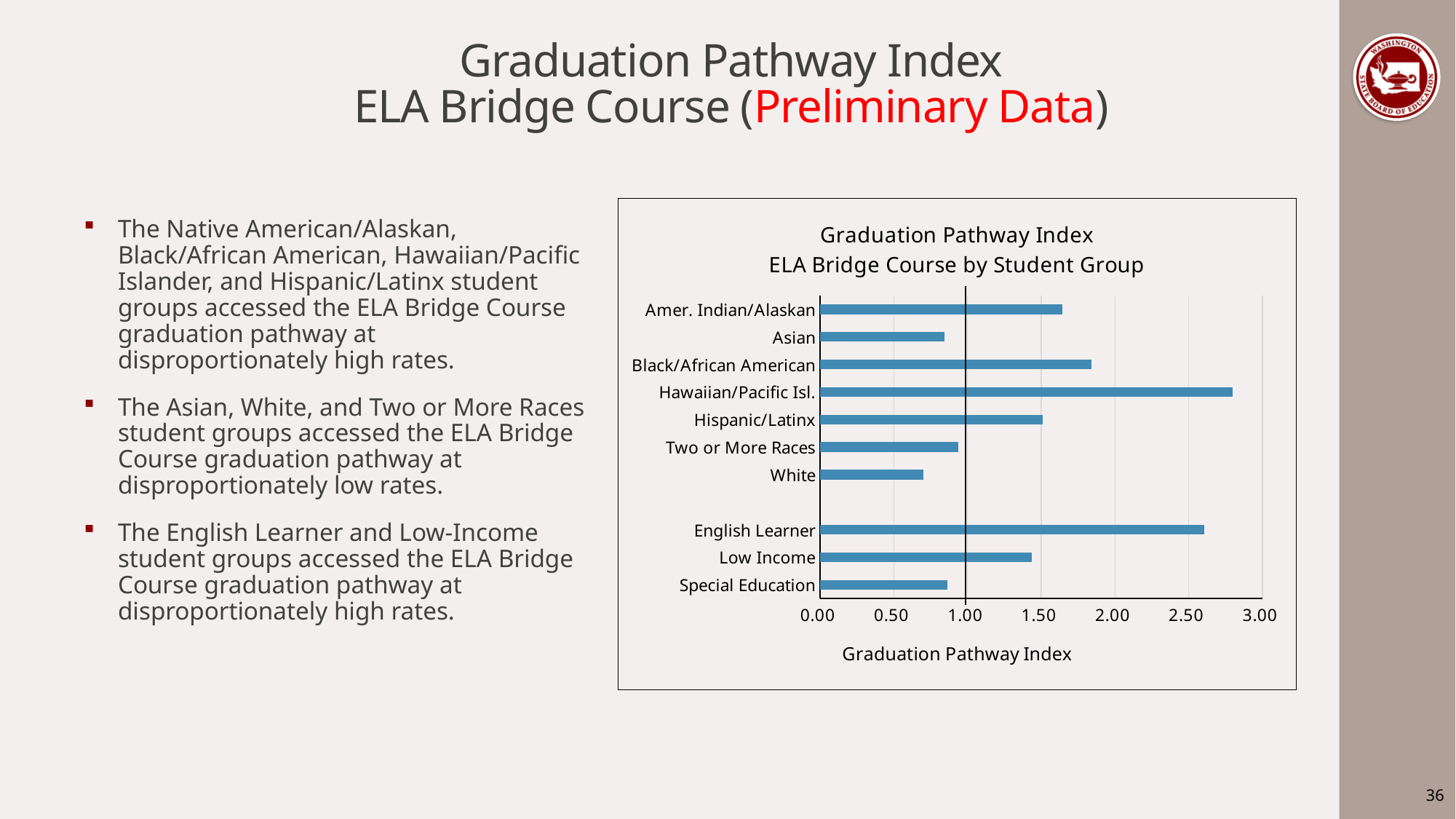
What is the title of the chart's horizontal axis? Graduation Pathway Index Is the Graduation Pathway Index for Hawaiian/Pacific Isl. greater or less than 2.50? greater Is the Graduation Pathway Index for White greater or less than 1.00? less Which has a higher Graduation Pathway Index, Black/African American or Amer. Indian/Alaskan? Black/African American Is the Graduation Pathway Index for Asian greater or less than 1.00? less Which student group has the highest Graduation Pathway Index in the chart? Hawaiian/Pacific Isl. What kind of chart is shown on the slide? Bar chart Which has a higher Graduation Pathway Index, English Learner or Low Income? English Learner Which student group has the lowest Graduation Pathway Index in the chart? White How many student groups are plotted in the chart? 10